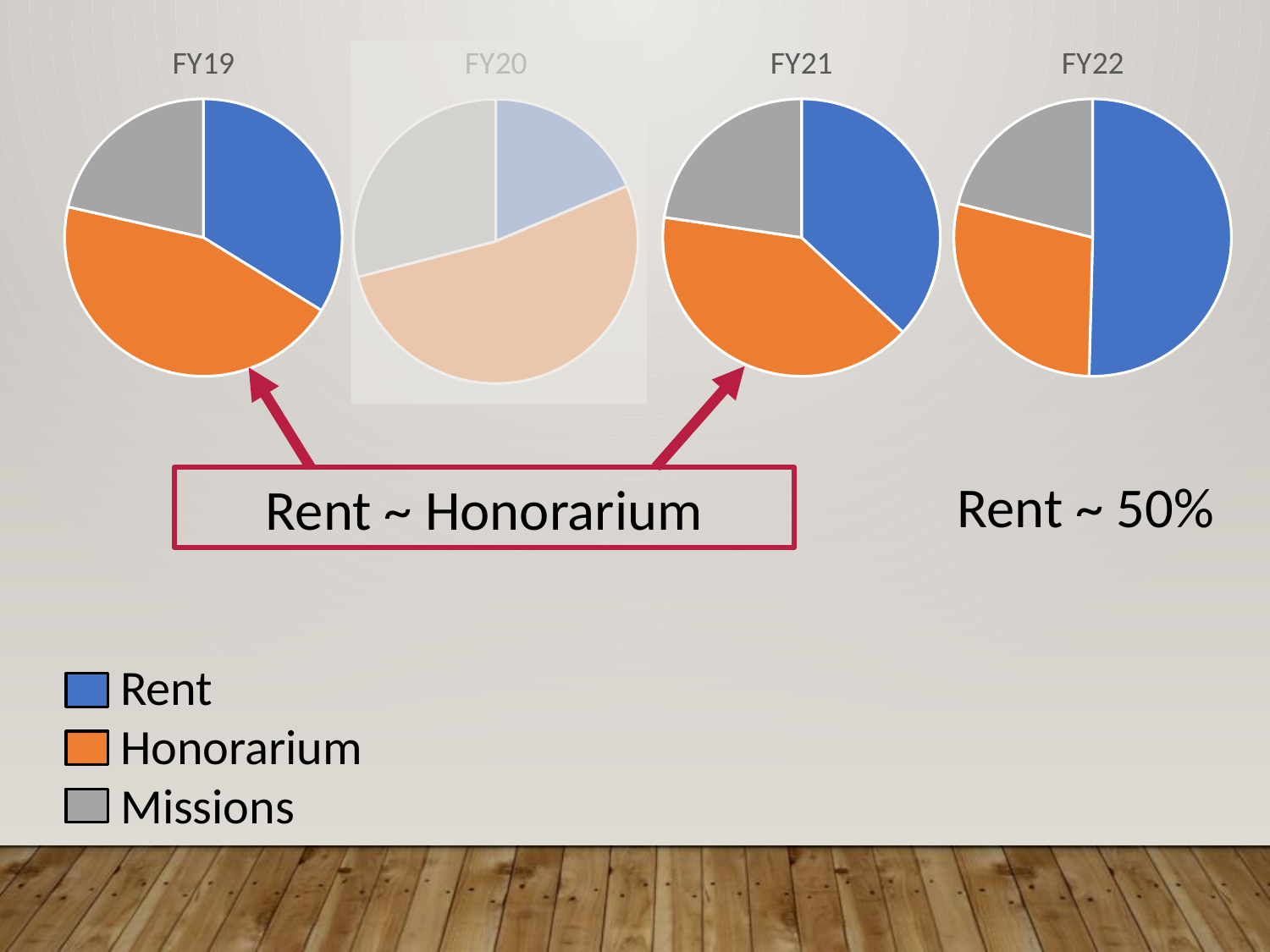
In the FY20 pie chart, which category has the smallest slice? Rent How many slices does the FY22 pie chart have? 3 Which colour represents Honorarium in the pie charts? orange What are the titles of the four pie charts, from left to right? FY19, FY20, FY21, FY22 In the FY22 pie chart, which category has the largest slice? Rent How many categories does the legend list? 3 In the FY21 pie chart, which slice is larger, Rent or Missions? Rent In the FY20 pie chart, which category has the largest slice? Honorarium In the FY22 pie chart, which slice is larger, Rent or Missions? Rent In the FY19 pie chart, which category has the smallest slice? Missions What kind of chart is used for FY19? pie chart How many pie charts are shown on the slide? 4